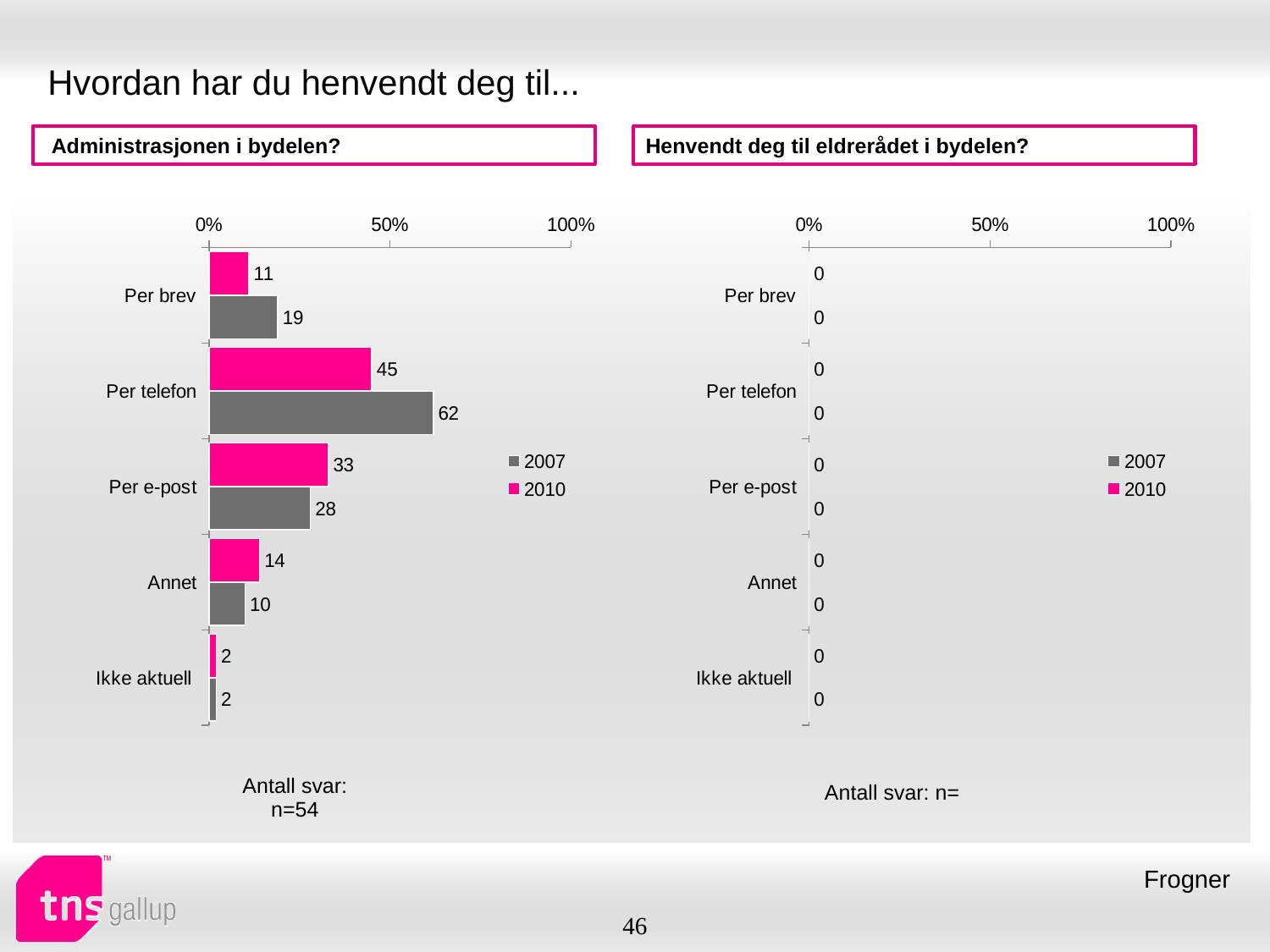
In the 'Henvendt deg til eldrerådet i bydelen?' chart, what is the value for Per telefon in 2010? 0 How many series does the legend of the 'Administrasjonen i bydelen?' chart list? 2 In the 'Administrasjonen i bydelen?' chart, what is the value for Per e-post in 2010? 33 In the 'Administrasjonen i bydelen?' chart, what is the value for Per telefon in 2007? 62 In the 'Administrasjonen i bydelen?' chart, what is the value for Per brev in 2007? 19 How many categories are shown in the 'Administrasjonen i bydelen?' chart? 5 In the 'Administrasjonen i bydelen?' chart, which category has the lowest value for 2007? Ikke aktuell In the 'Administrasjonen i bydelen?' chart, what is the difference between the 2007 and 2010 values for Per telefon? 17 What kind of chart is the 'Henvendt deg til eldrerådet i bydelen?' chart? Bar chart In the 'Administrasjonen i bydelen?' chart, which is larger for Per e-post: the 2007 value or the 2010 value? 2010 In the 'Administrasjonen i bydelen?' chart, is the 2007 value for Per telefon greater or less than 50%? greater In the 'Administrasjonen i bydelen?' chart, which category has the highest value for 2010? Per telefon